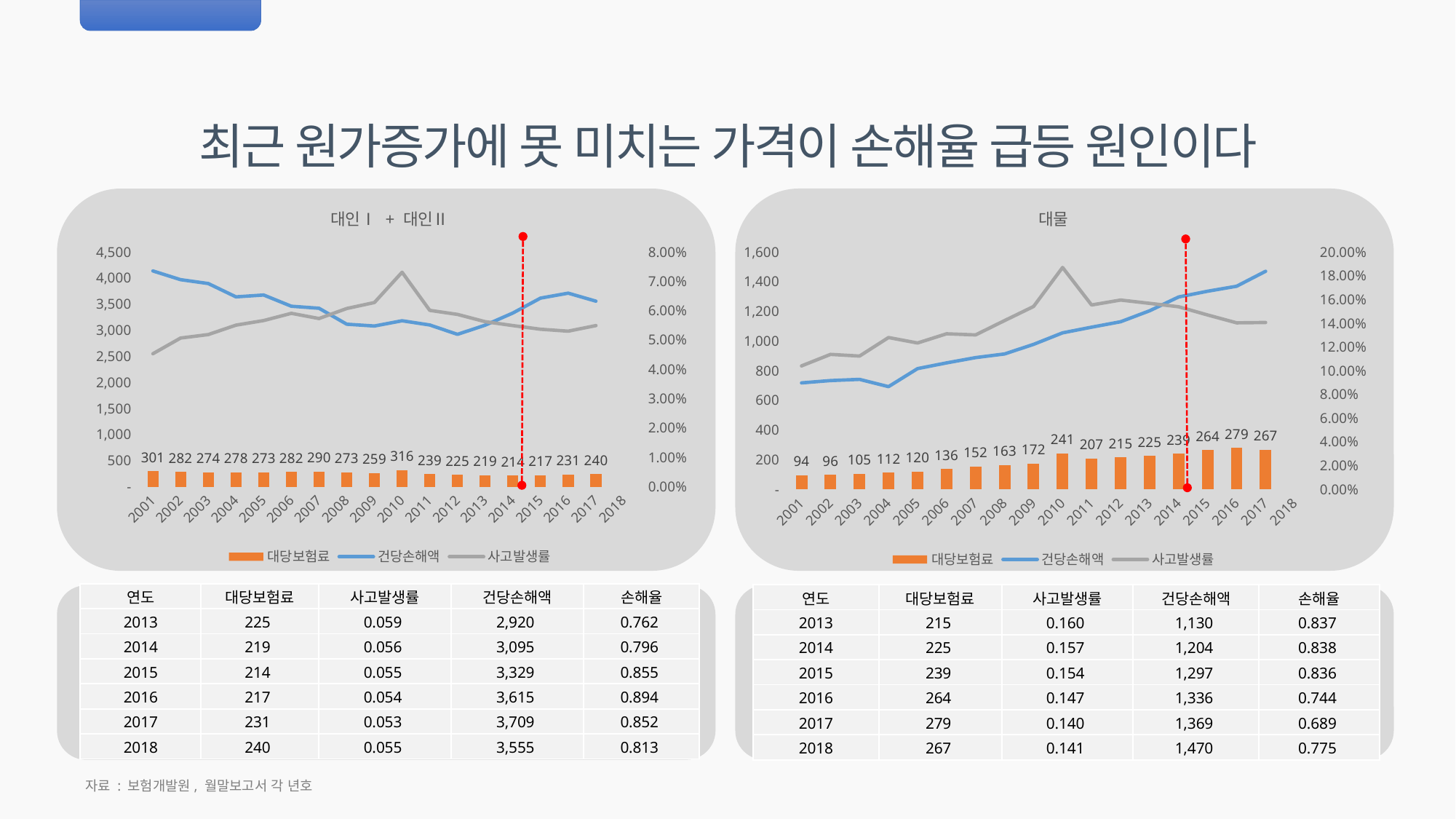
How many 대당보험료 bars are plotted in the right chart (대물)? 17 In the left chart (대인Ⅰ + 대인Ⅱ), what is the highest value labelled on the 대당보험료 bars? 316 In the right chart (대물), what is the highest value labelled on the 대당보험료 bars? 279 In the right chart (대물), what is the lowest value labelled on the 대당보험료 bars? 94 What kind of chart is the left chart titled 대인Ⅰ + 대인Ⅱ? bar and line chart In the left chart (대인Ⅰ + 대인Ⅱ), what colour represents 대당보험료 in the legend? orange In the right chart (대물), what is the difference between the highest and lowest 대당보험료 bar values? 185 In the left chart (대인Ⅰ + 대인Ⅱ), which is larger: the first 대당보험료 bar or the last 대당보험료 bar? the first bar (301) How many series does the legend of the right chart (대물) list? 3 In the right chart (대물), what is the value labelled on the first 대당보험료 bar? 94 In the right chart (대물), does the 건당손해액 line generally rise or fall from left to right? rise In the left chart (대인Ⅰ + 대인Ⅱ), what is the lowest value labelled on the 대당보험료 bars? 214